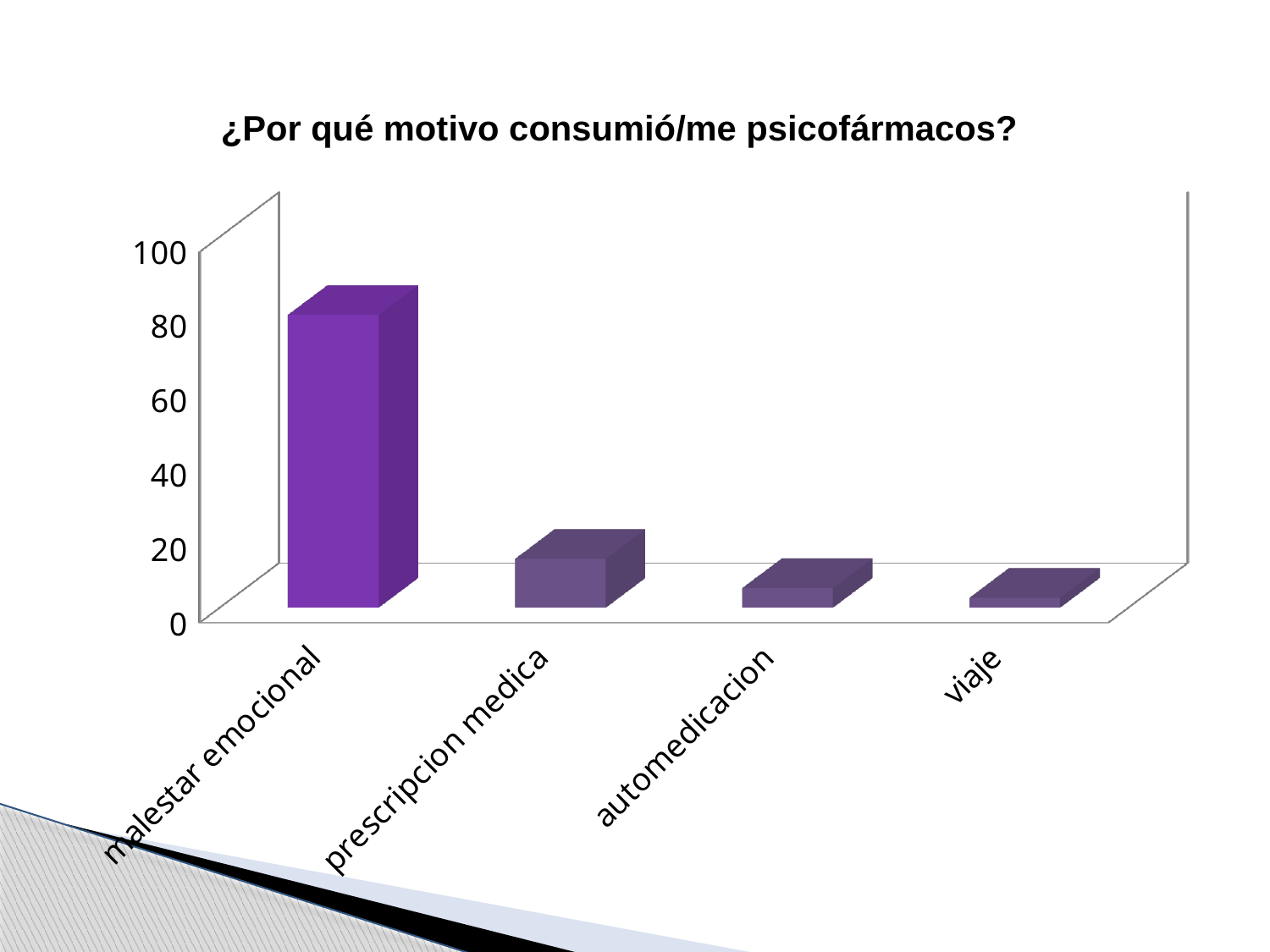
Which category has the lowest value? viaje What colour are the bars in the chart? Purple Is the value for prescripcion medica greater or less than 40? less Is the value for viaje greater or less than 20? less Which is larger, the value for prescripcion medica or the value for automedicacion? prescripcion medica What is the title of the chart? ¿Por qué motivo consumió/me psicofármacos? Is the value for automedicacion greater or less than 20? less What type of chart is shown on the slide? Bar chart How many categories are shown on the x axis of the chart? 4 Which category has the highest value? malestar emocional Do the values rise or fall moving from left to right along the x axis? fall